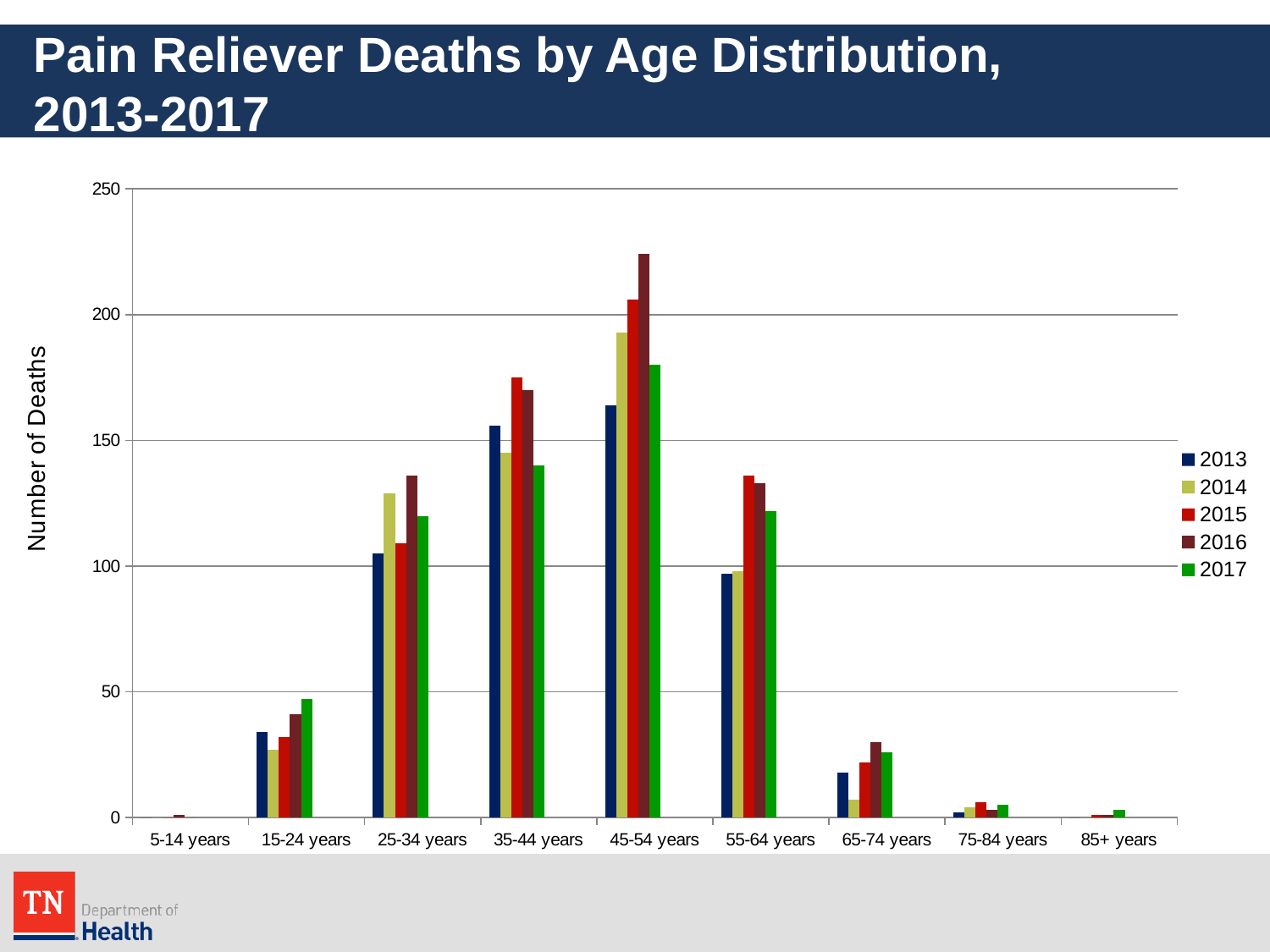
What kind of chart is shown on the slide? bar chart What is the label on the y axis? Number of Deaths How many series does the legend list? 5 Is the value for 55-64 years in 2017 greater or less than 100? greater Which age group has the highest number of deaths for 2016? 45-54 years Which age group has the lowest number of deaths across all years? 5-14 years Which is larger for 2016: the value for 45-54 years or the value for 35-44 years? 45-54 years Which is larger for 25-34 years: the value for 2014 or the value for 2013? 2014 Is the value for 45-54 years in 2016 greater or less than 200? greater How many age groups are shown on the x axis? 9 Is the value for 35-44 years in 2013 greater or less than 150? greater